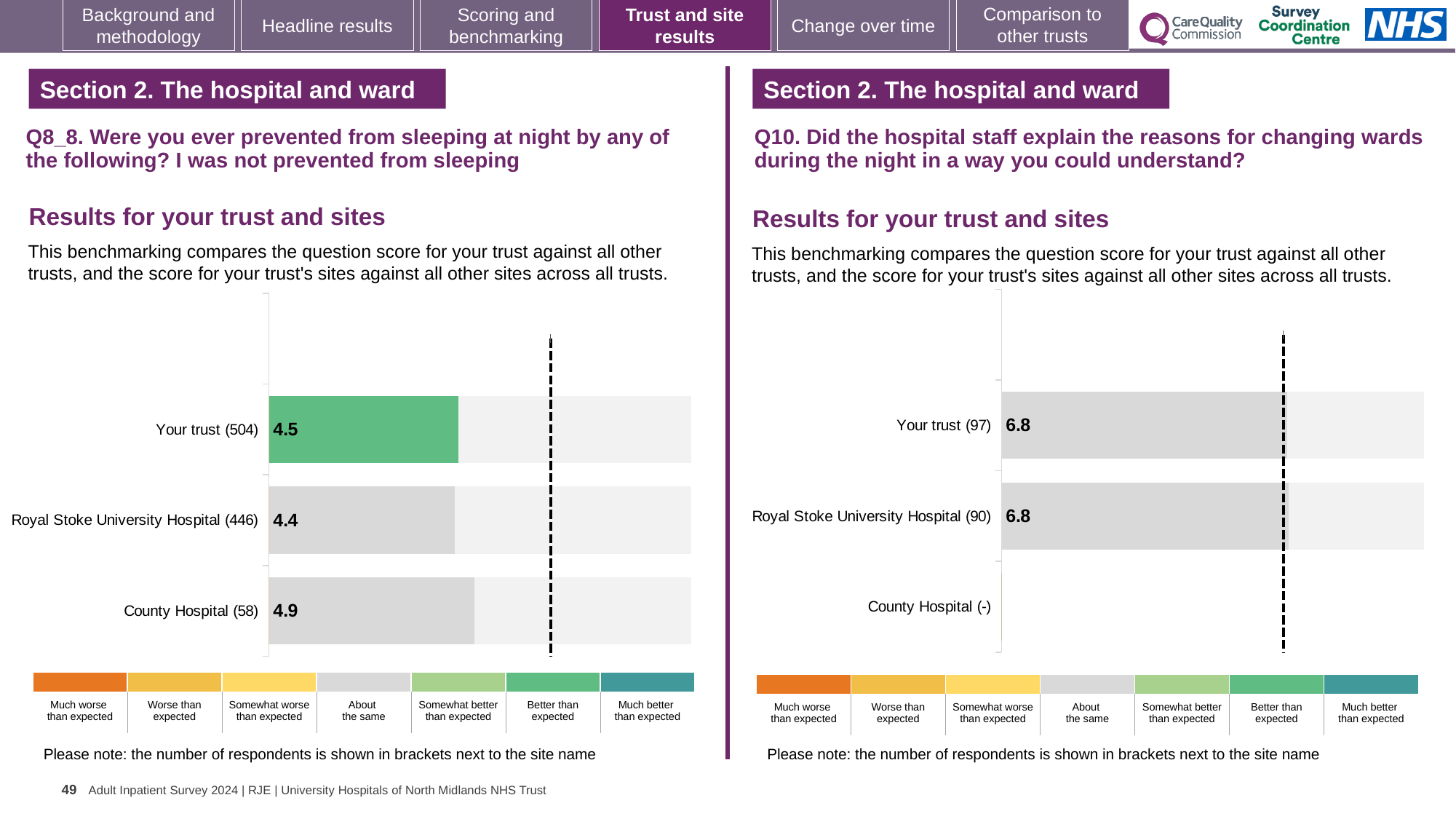
On the Q10 chart (right), how many sites or trusts are listed on the vertical axis? 3 On the Q8_8 chart (left), which site or trust has the highest score? County Hospital (58) On the Q8_8 chart (left), what is the score for Royal Stoke University Hospital (446)? 4.4 On the Q8_8 chart (left), which site or trust has the lowest score? Royal Stoke University Hospital (446) On the Q8_8 chart (left), what is the score for Your trust (504)? 4.5 On the Q8_8 chart (left), what is the difference between the County Hospital score and the Royal Stoke University Hospital score? 0.5 On the Q10 chart (right), what is the score for Your trust (97)? 6.8 On the Q8_8 chart (left), what is the score for County Hospital (58)? 4.9 On the Q10 chart (right), what is the score for Royal Stoke University Hospital (90)? 6.8 On the Q8_8 chart (left), which has the larger score, Your trust or Royal Stoke University Hospital? Your trust On the Q8_8 chart (left), which bar is coloured green rather than grey? Your trust (504) What kind of chart is the Q8_8 chart on the left? Bar chart